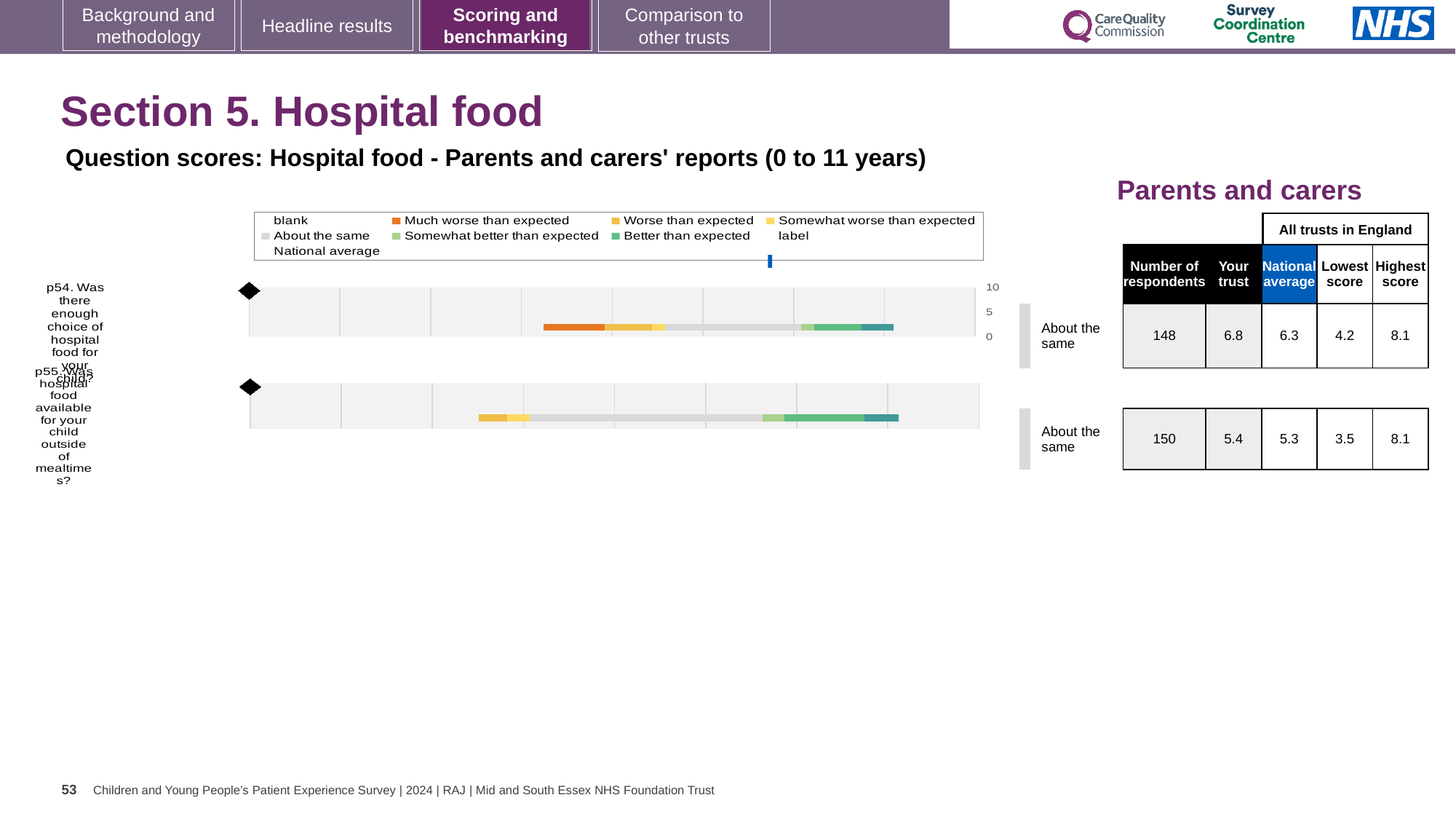
What is the 'Your trust' score for p54 (enough choice of hospital food for your child)? 6.8 What is the difference between the 'Your trust' score and the national average for p54? 0.5 Which colour does the legend use for 'Much worse than expected'? Orange What is the lowest score among all trusts in England for p54? 4.2 Which question has the higher 'Your trust' score, p54 or p55? p54 What is the difference between the highest and lowest scores in England for p55? 4.6 How many questions (bars) are plotted in the hospital food chart? 2 What kind of chart is used to show the question scores for hospital food? Bar chart What is the highest value shown on the chart's numeric axis? 10 What is the national average score for p55 (hospital food available outside of mealtimes)? 5.3 How many respondents answered p55? 150 What benchmark category is given for both p54 and p55? About the same